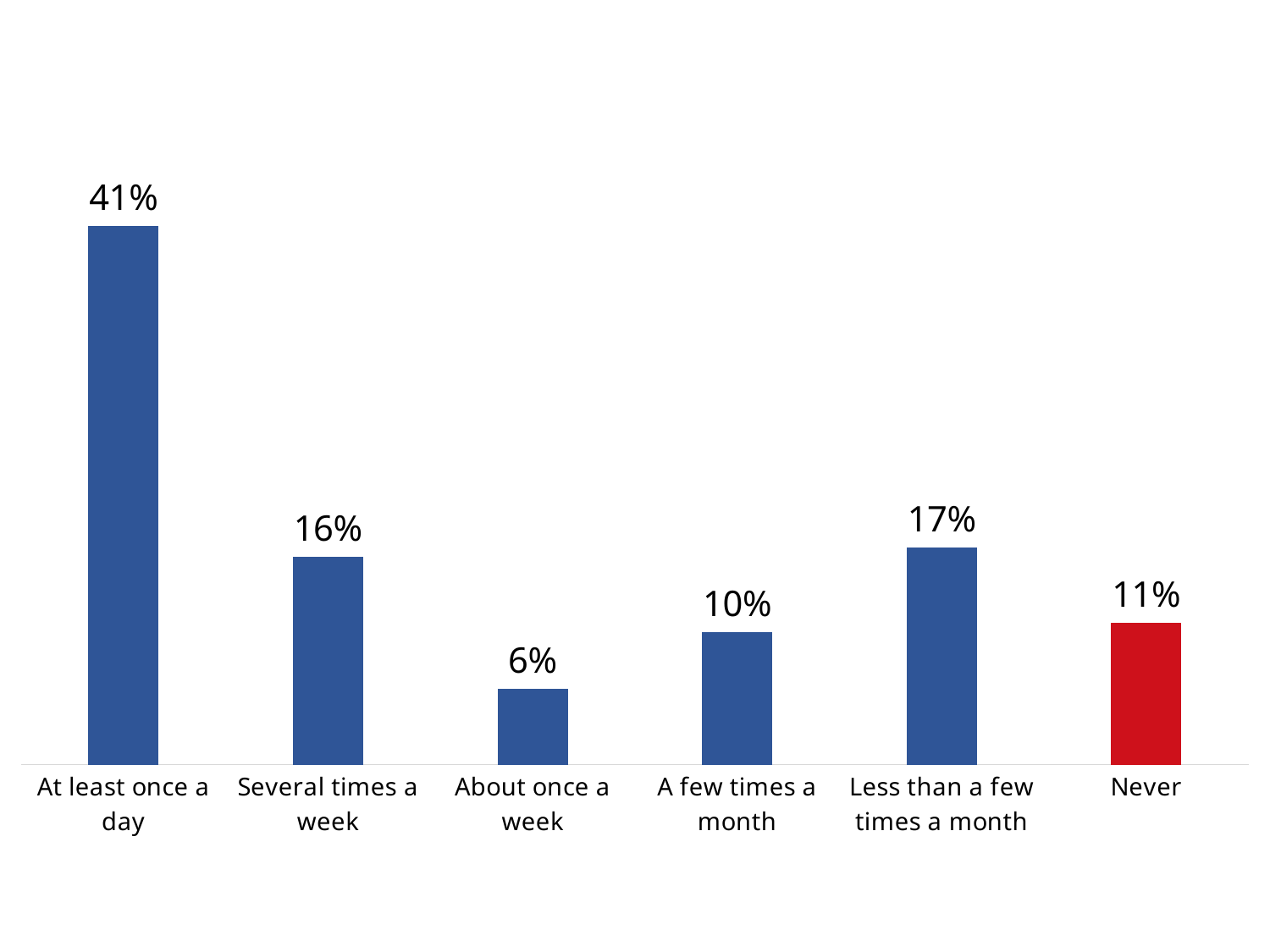
What is the value for "Several times a week"? 16% How many categories are shown in the chart? 6 Which category has the highest value? At least once a day What is the difference between the values for "At least once a day" and "Less than a few times a month"? 24% What is the value for "Never"? 11% Which category has the lowest value? About once a week Which bar is coloured red rather than blue? Never What is the value for "At least once a day"? 41% What is the difference between the values for "Less than a few times a month" and "Never"? 6% What kind of chart is shown on the slide? Bar chart Which is larger, the value for "Several times a week" or the value for "A few times a month"? Several times a week What is the value for "About once a week"? 6%